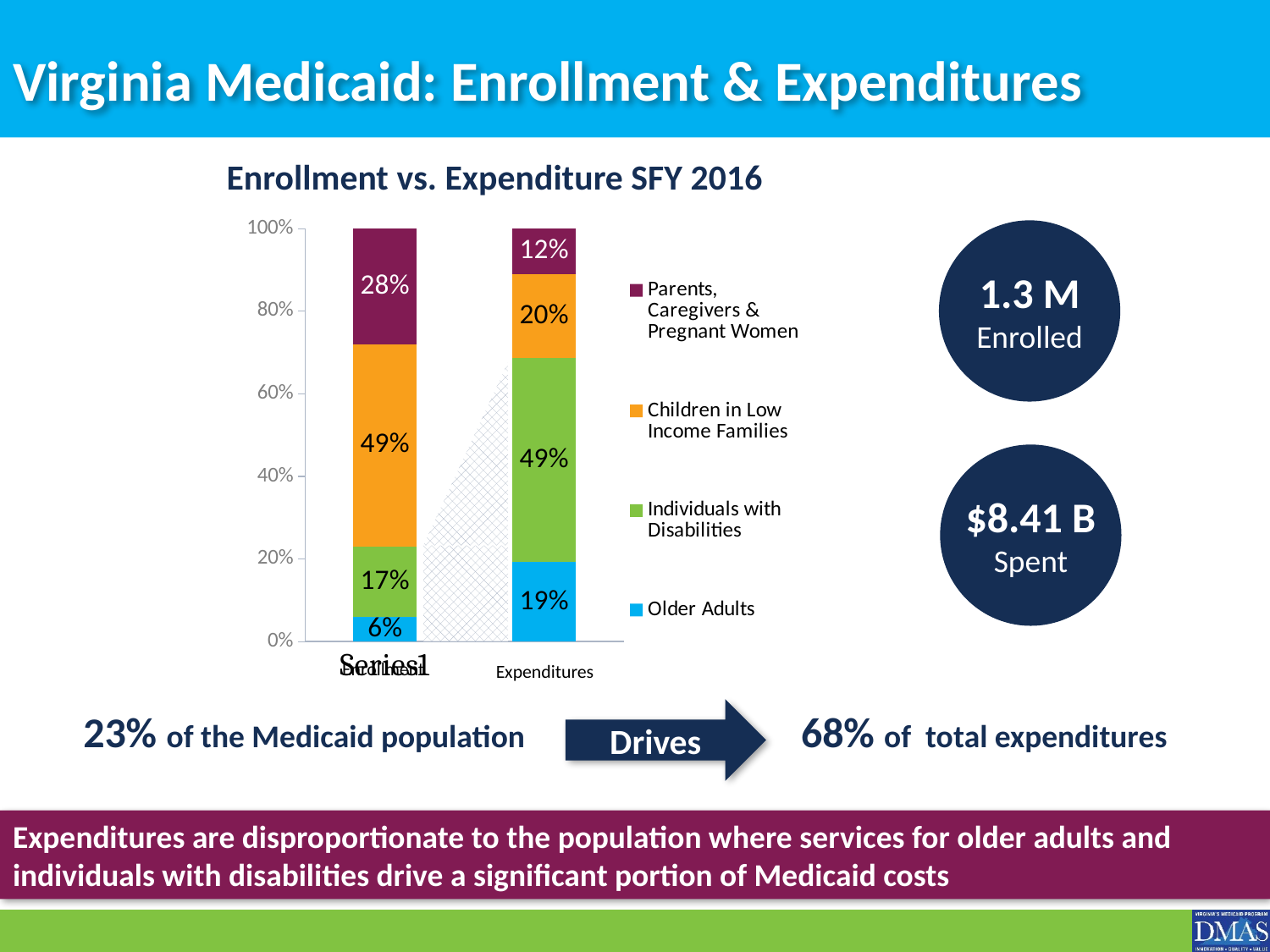
What kind of chart is shown under the title "Enrollment vs. Expenditure SFY 2016"? Stacked bar chart What is the value for Children in Low Income Families in the left (Enrollment) bar? 49% What is the combined share of Older Adults and Individuals with Disabilities in the Expenditures bar? 68% Which series has the largest share in the Expenditures bar? Individuals with Disabilities What is the difference between the Older Adults value in the Expenditures bar and in the left (Enrollment) bar? 13% Is the Parents, Caregivers & Pregnant Women share larger in the left (Enrollment) bar or in the Expenditures bar? Enrollment Which series has the smallest share in the left (Enrollment) bar? Older Adults What is the value for Individuals with Disabilities in the left (Enrollment) bar? 17% What is the value for Parents, Caregivers & Pregnant Women in the Expenditures bar? 12% How many series does the legend of the chart list? 4 Which colour represents Older Adults in the chart? Blue What is the value for Older Adults in the Expenditures bar? 19%